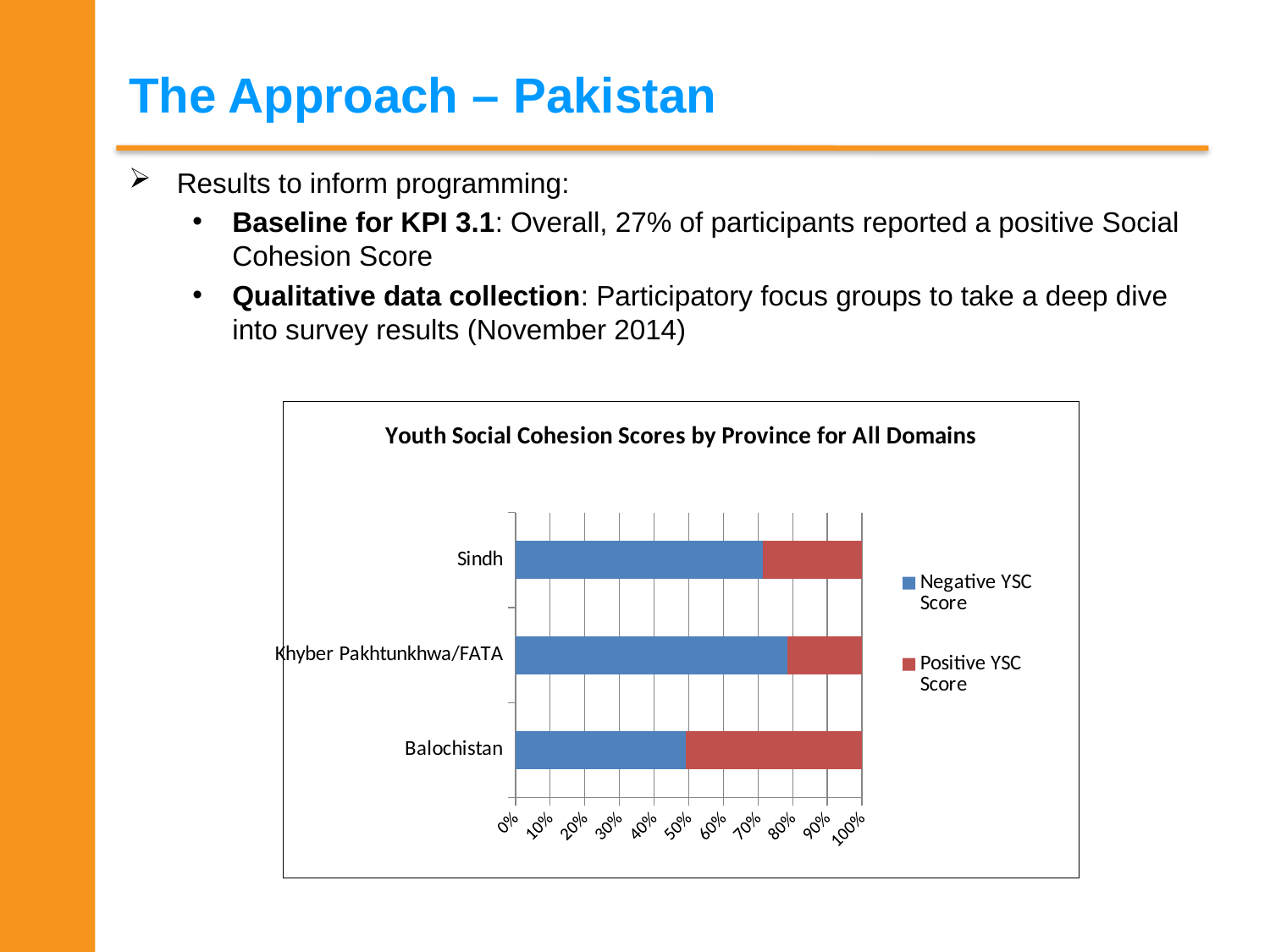
Is the Negative YSC Score share for Balochistan greater or less than 60%? less Which colour represents the Positive YSC Score series? red Which province has the smallest Negative YSC Score share? Balochistan What is the title of the chart? Youth Social Cohesion Scores by Province for All Domains What kind of chart is shown on the slide? bar chart Which has a larger Negative YSC Score share, Sindh or Balochistan? Sindh Which province has the largest Positive YSC Score share? Balochistan How many provinces are shown on the chart? 3 How many series does the chart's legend list? 2 Which province has the largest Negative YSC Score share? Khyber Pakhtunkhwa/FATA Is the Negative YSC Score share for Sindh greater or less than 60%? greater Is the Negative YSC Score share for Khyber Pakhtunkhwa/FATA greater or less than 70%? greater